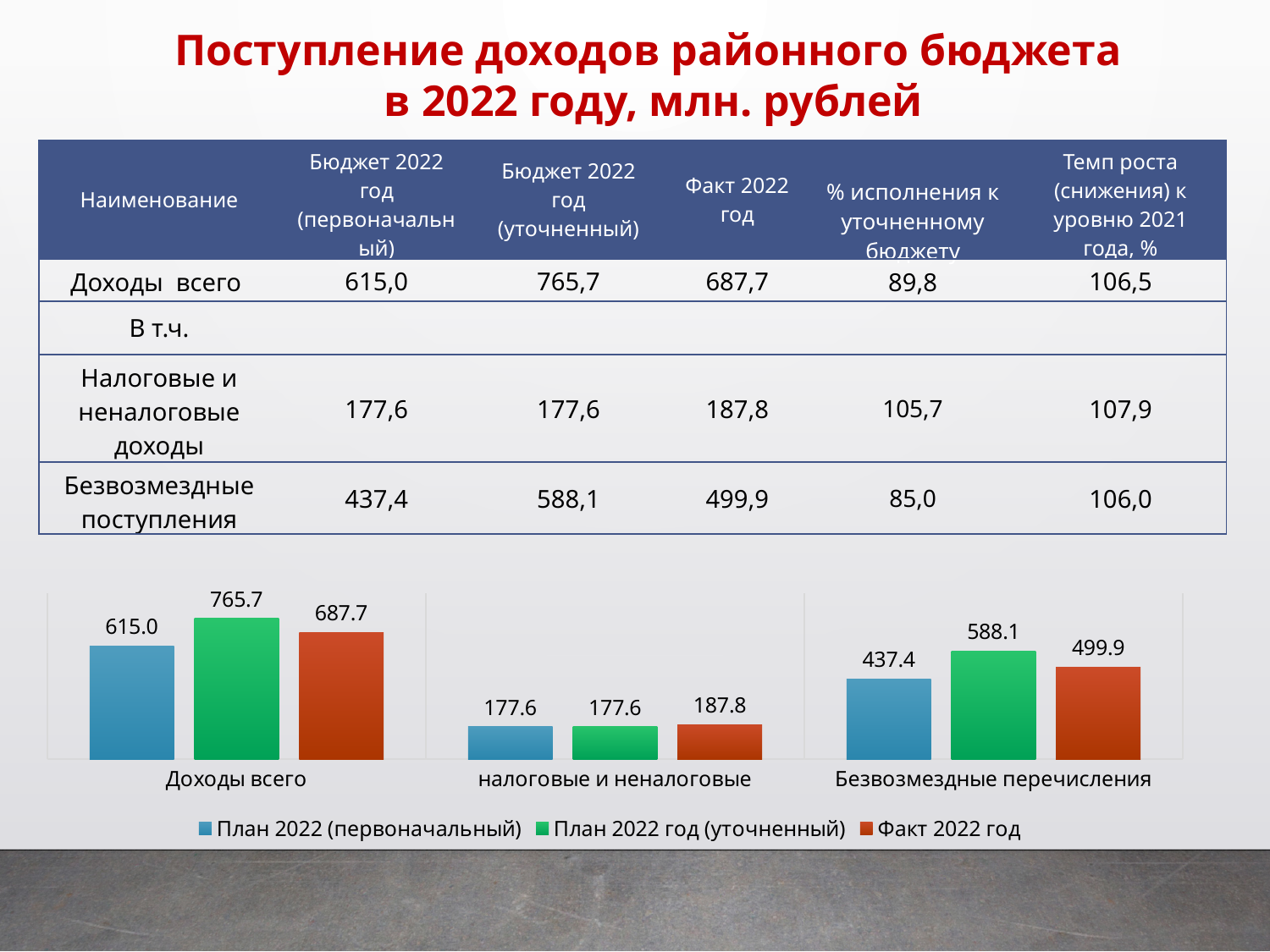
For Доходы всего, which is larger in the chart: План 2022 (первоначальный) or Факт 2022 год? Факт 2022 год Which category has the lowest value for План 2022 год (уточненный) in the chart? налоговые и неналоговые How many categories are shown on the x axis of the chart? 3 What is the value of Факт 2022 год for налоговые и неналоговые in the chart? 187.8 How many series does the chart legend list? 3 Which category has the highest value for Факт 2022 год in the chart? Доходы всего Which colour represents Факт 2022 год in the chart legend? Red (orange-red) What is the value of План 2022 год (уточненный) for Доходы всего in the chart? 765.7 What is the difference between Факт 2022 год and План 2022 (первоначальный) for Доходы всего in the chart? 72.7 What is the difference between План 2022 год (уточненный) and Факт 2022 год for Безвозмездные перечисления in the chart? 88.2 What type of chart is shown on the slide? Bar chart What is the value of План 2022 (первоначальный) for Безвозмездные перечисления in the chart? 437.4